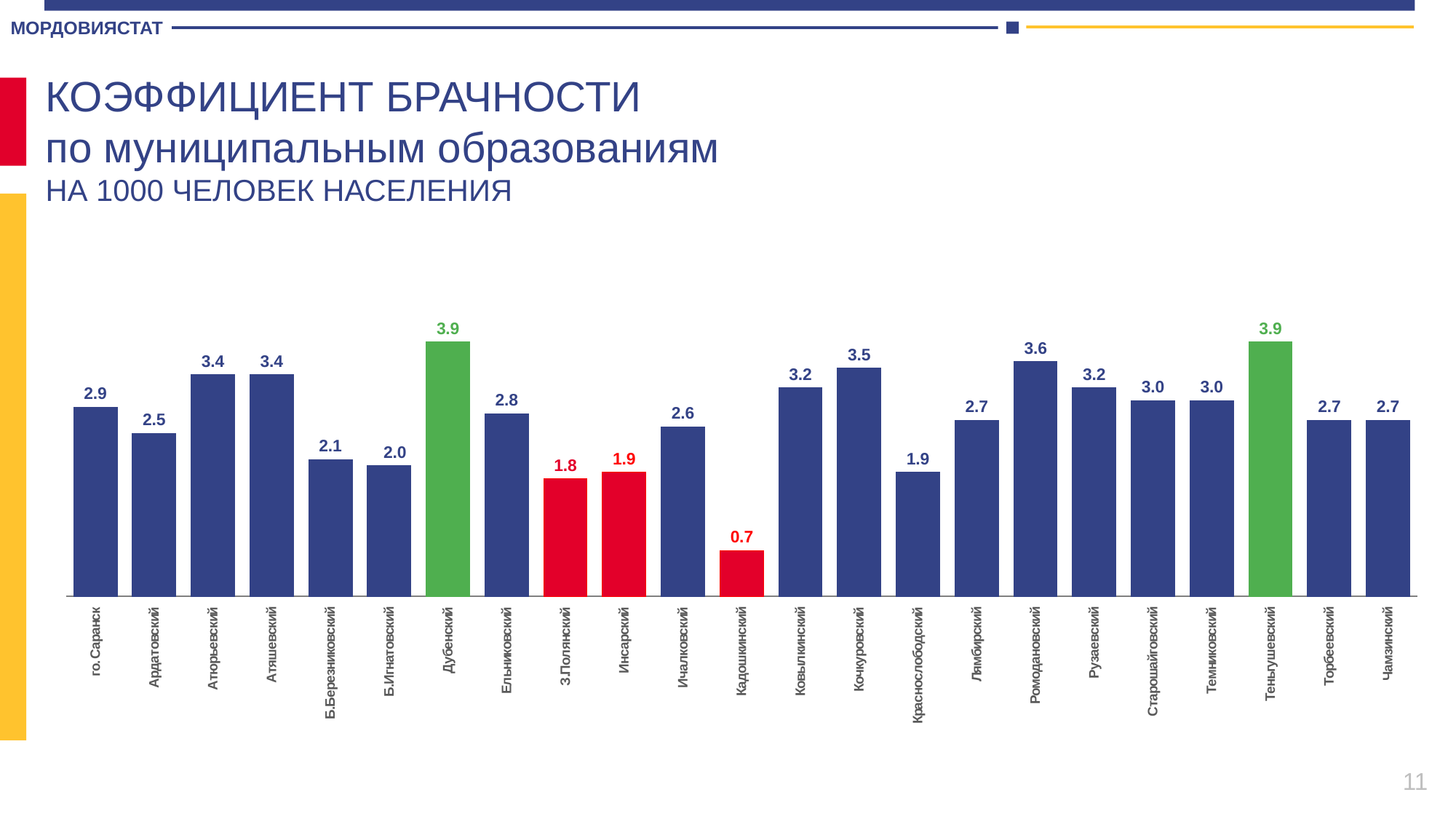
What is the difference between the values for Дубенский and Кадошкинский? 3.2 What is the marriage rate value shown for Кадошкинский? 0.7 Which has a larger value, Ковылкинский or Ельниковский? Ковылкинский Which has a larger value, Б.Игнатовский or Ичалковский? Ичалковский What value is shown for го.Саранск? 2.9 Which municipality has the lowest value on the chart? Кадошкинский What is the difference between the values for Ромодановский and Ардатовский? 1.1 What kind of chart is shown on the slide? Bar chart How many municipalities are shown on the chart? 23 What value is shown for Кочкуровский? 3.5 Which municipalities share the highest value on the chart? Дубенский and Теньгушевский What value is shown for Ромодановский? 3.6